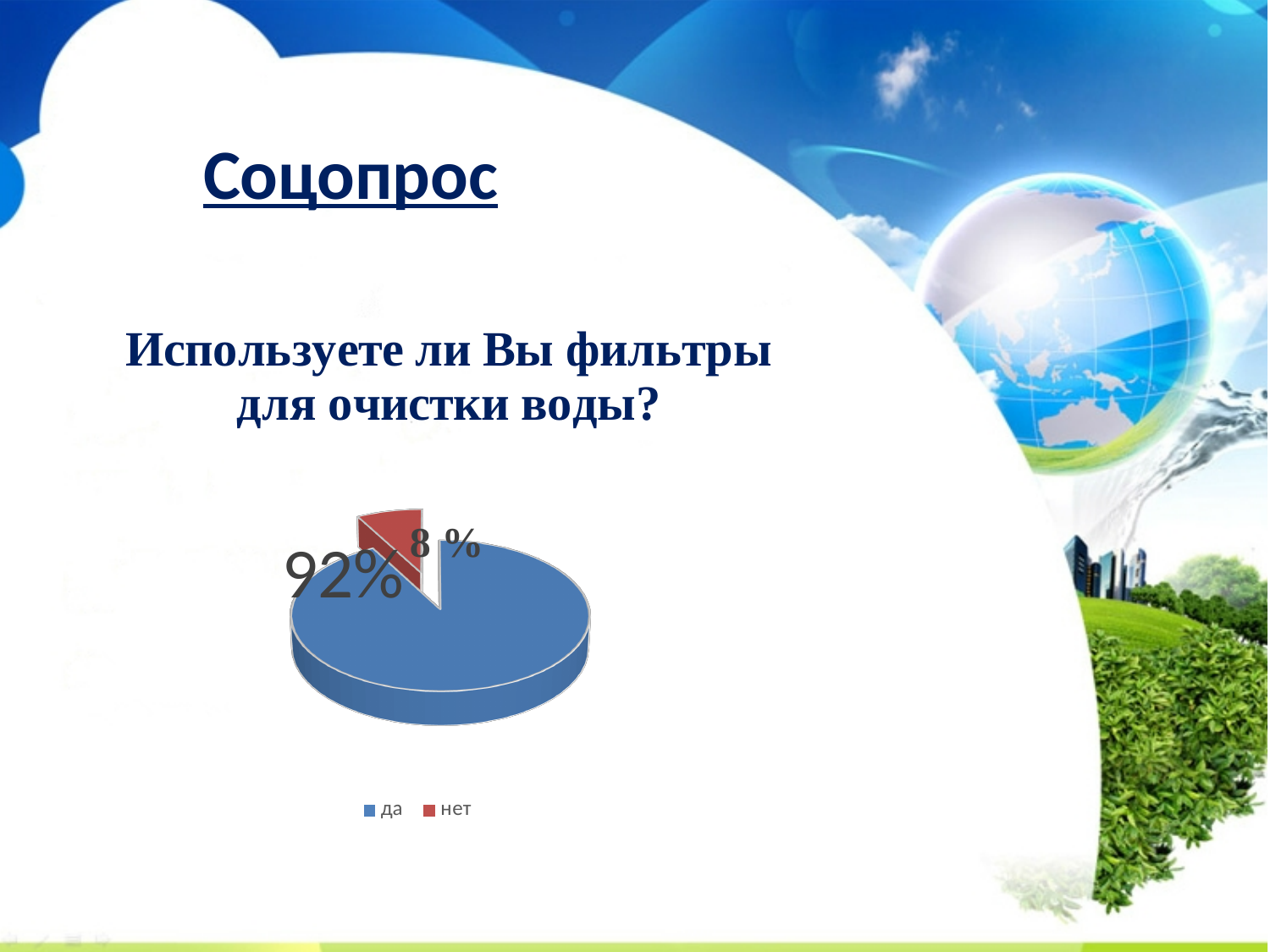
Which is larger, the "да" slice or the "нет" slice? да What is the difference in percentage points between the "да" and "нет" slices? 84 What share of the pie does the "да" slice represent? 92% Which slice of the pie is the largest? да How many entries does the legend list? 2 What share of the pie does the "нет" slice represent? 8 % Which slice of the pie is the smallest? нет What question is the pie chart answering, according to the text above it? Используете ли Вы фильтры для очистки воды? How many slices does the pie chart have? 2 What kind of chart is shown on the slide? pie chart What colour is the "нет" slice? red